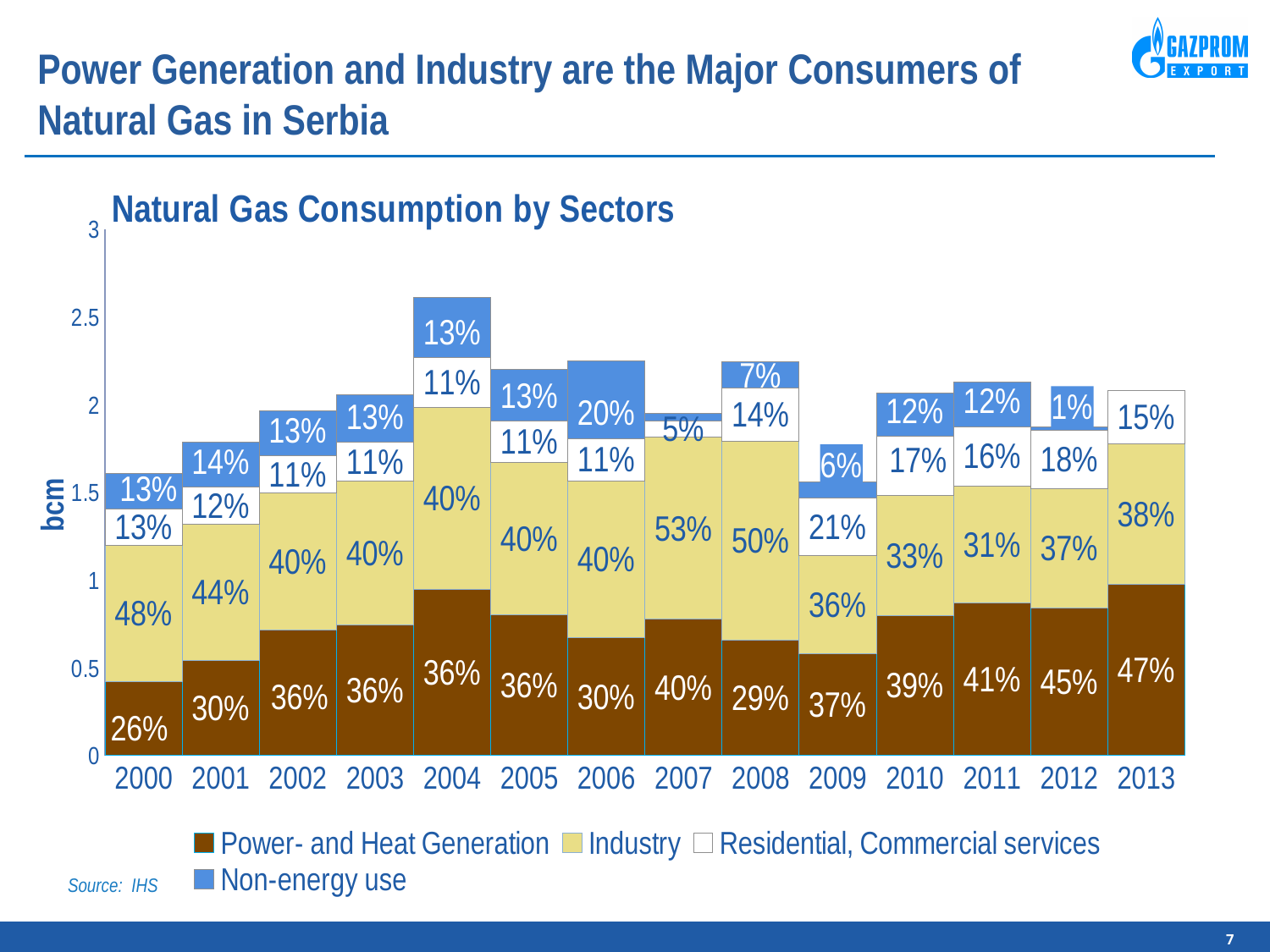
What share of natural gas consumption did Non-energy use account for in 2006? 20% In 2013, how many percentage points larger is the Power- and Heat Generation share than the Industry share? 9 percentage points What share of natural gas consumption did Power- and Heat Generation account for in 2000? 26% What is the title of the chart? Natural Gas Consumption by Sectors In which year was the Power- and Heat Generation share the highest? 2013 What share of natural gas consumption did Residential, Commercial services account for in 2009? 21% What type of chart is shown on the slide? Stacked bar chart Is the total natural gas consumption in 2004 greater or less than 2 bcm? greater In which year was the Power- and Heat Generation share the lowest? 2000 What share of natural gas consumption did Industry account for in 2007? 53% How many years are shown on the x axis? 14 How many series does the legend list? 4